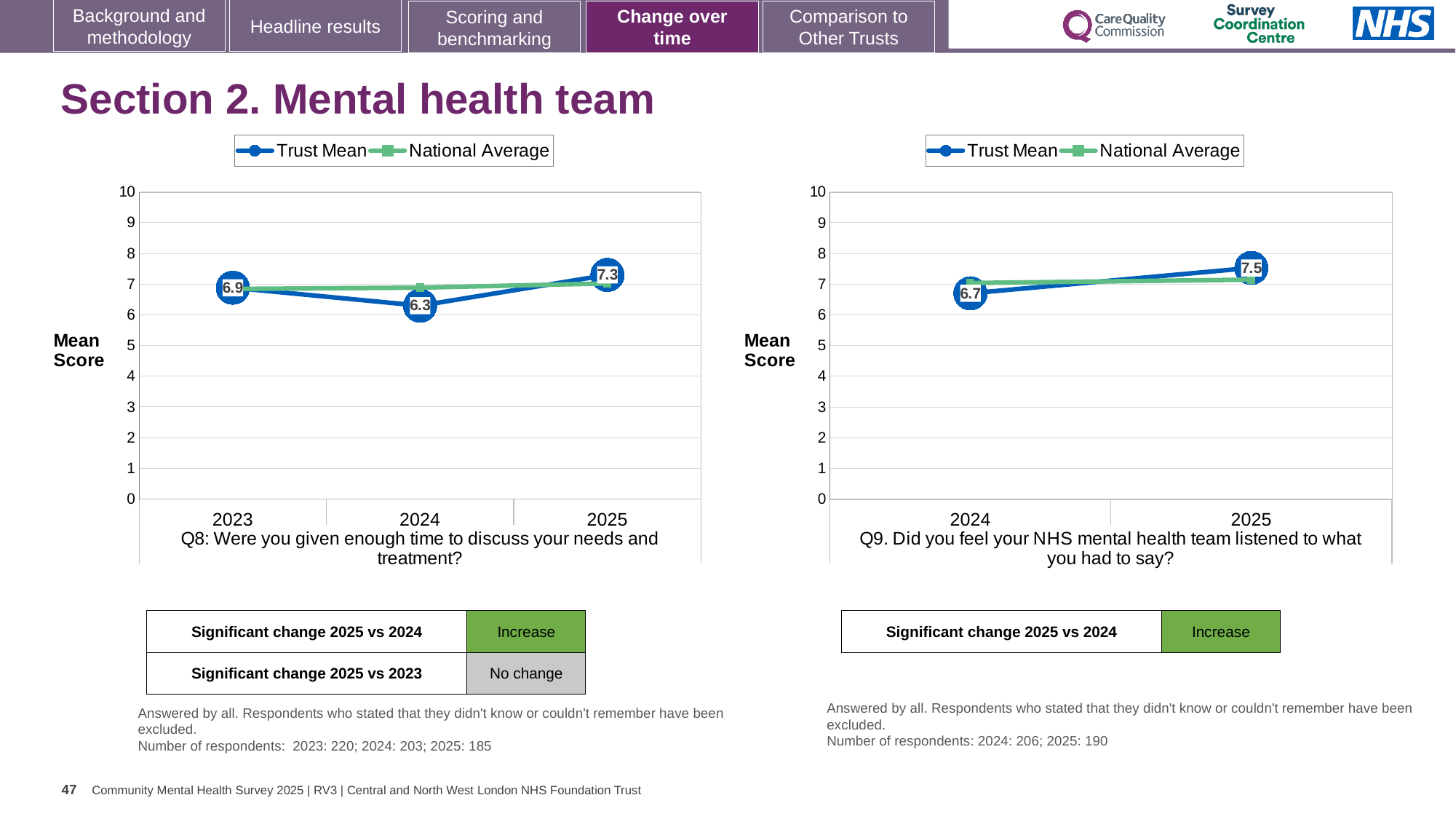
In the left chart (Q8), is the Trust Mean for 2023 or 2025 larger? 2025 How many series does the legend of the right chart (Q9) list? 2 In the left chart (Q8), what is the Trust Mean for 2025? 7.3 In the left chart (Q8), which year has the highest Trust Mean? 2025 In the right chart (Q9), is the National Average for 2025 greater or less than 6? greater In the right chart (Q9), what is the difference between the Trust Mean for 2025 and 2024? 0.8 In the left chart (Q8), which year has the lowest Trust Mean? 2024 How many years are shown on the x axis of the left chart (Q8)? 3 In the left chart (Q8), what is the Trust Mean for 2024? 6.3 What type of chart is used for Q9 on the right? Line chart In the right chart (Q9), what is the Trust Mean for 2025? 7.5 In the right chart (Q9), what is the Trust Mean for 2024? 6.7